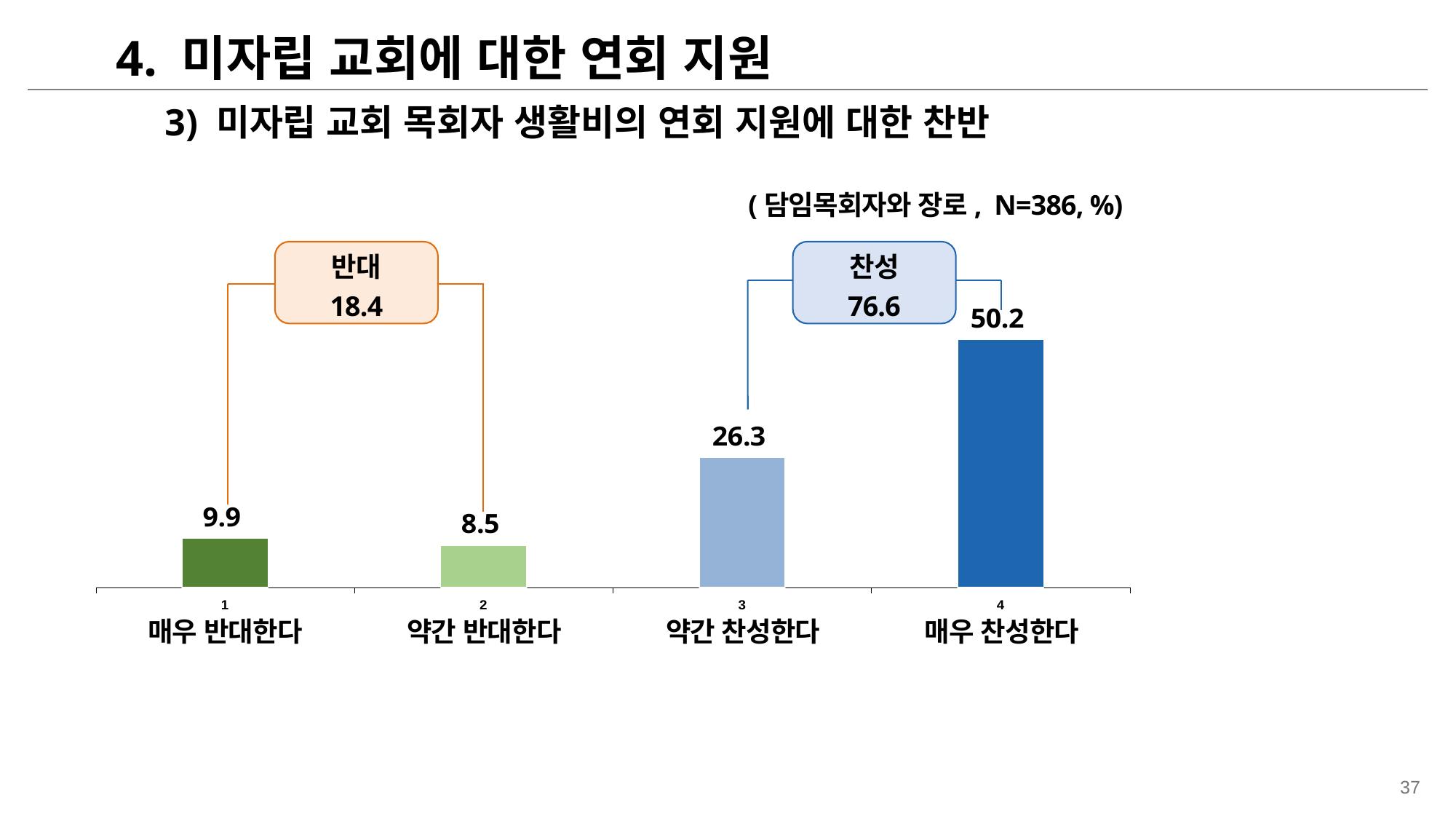
Which category has the lowest value? 약간 반대한다 What is the value for 약간 찬성한다? 26.3 What is the value for 매우 찬성한다? 50.2 What combined value is shown in the 찬성 box above the chart? 76.6 What is the value for 약간 반대한다? 8.5 What is the value for 매우 반대한다? 9.9 What combined value is shown in the 반대 box above the chart? 18.4 What kind of chart is shown on the slide? bar chart Which is larger, the value for 매우 반대한다 or 약간 반대한다? 매우 반대한다 How many categories are shown on the x axis? 4 What is the difference between the values for 매우 찬성한다 and 약간 찬성한다? 23.9 Which category has the highest value? 매우 찬성한다